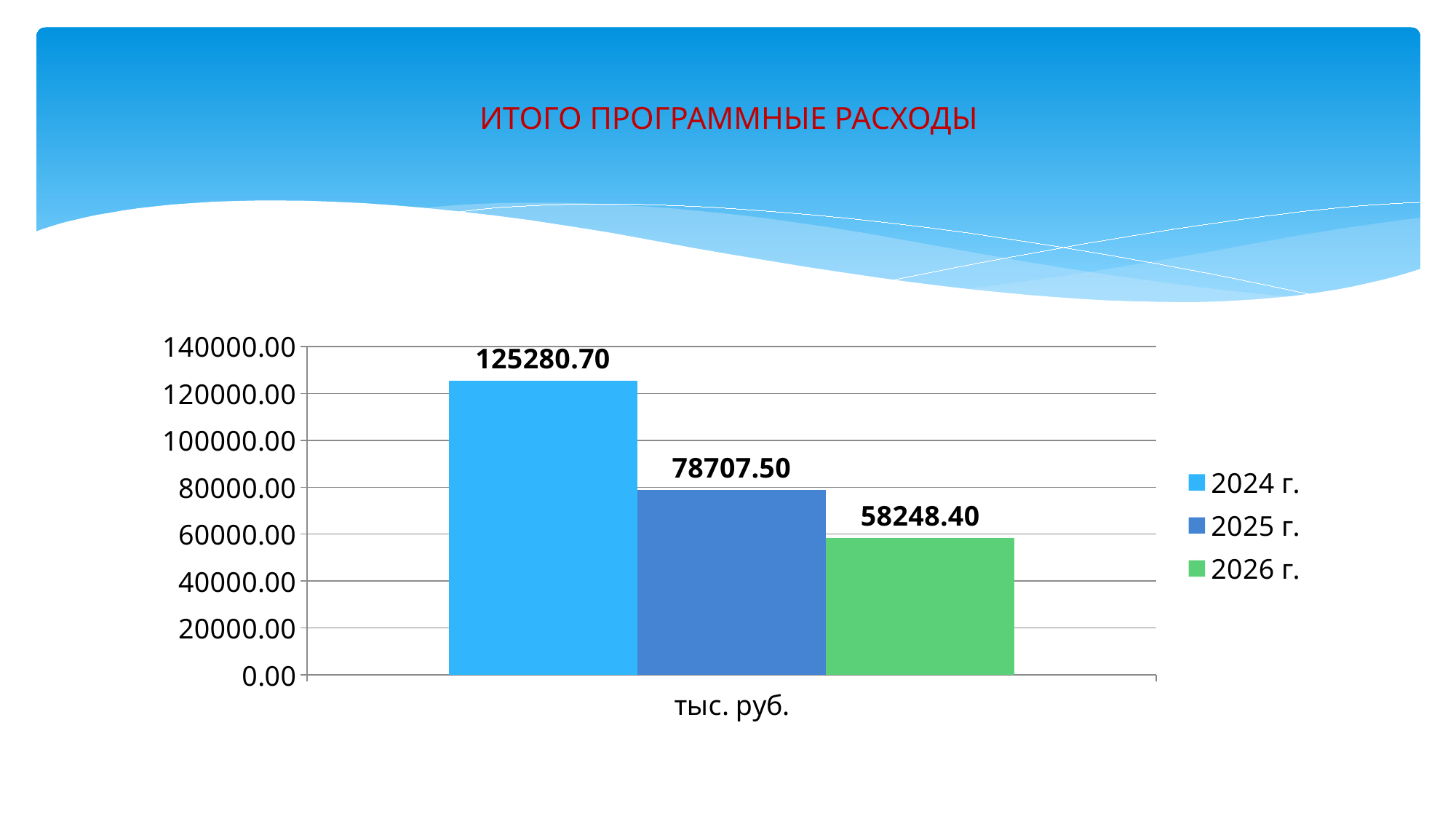
What is the difference between the values for 2025 г. and 2026 г.? 20459.10 What is the title of the chart? ИТОГО ПРОГРАММНЫЕ РАСХОДЫ What is the value for 2024 г.? 125280.70 Is the value for 2024 г. greater or less than 120000.00? greater Which year has the lowest value? 2026 г. Which year has the highest value? 2024 г. What kind of chart is shown on the slide? bar chart What is the value for 2026 г.? 58248.40 What is the value for 2025 г.? 78707.50 Which is larger, the value for 2025 г. or the value for 2026 г.? 2025 г. What is the difference between the values for 2024 г. and 2025 г.? 46573.20 How many series does the legend list? 3